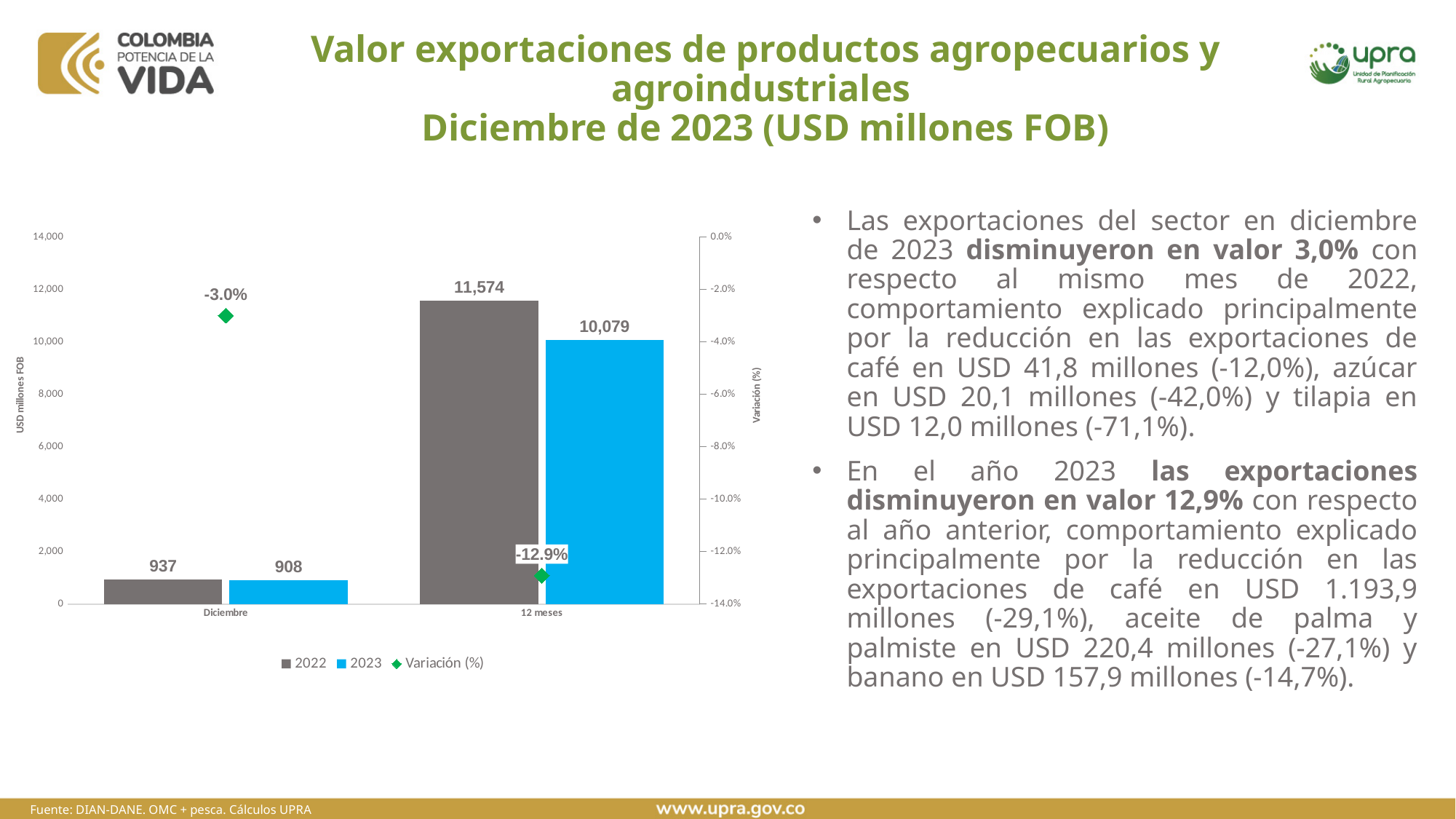
What is the value for 2023 in the Diciembre category? 908 What is the value for 2023 in the 12 meses category? 10,079 What is the Variación (%) value for the Diciembre category? -3.0% What colour are the 2023 bars? Blue What is the Variación (%) value for the 12 meses category? -12.9% How many categories are shown on the x axis? 2 What is the difference between the 2022 and 2023 values in the 12 meses category? 1,495 What is the value for 2022 in the 12 meses category? 11,574 Which is larger in the 12 meses category, the 2022 value or the 2023 value? 2022 How many series does the legend list? 3 What is the difference between the 2022 and 2023 values in the Diciembre category? 29 What is the value for 2022 in the Diciembre category? 937